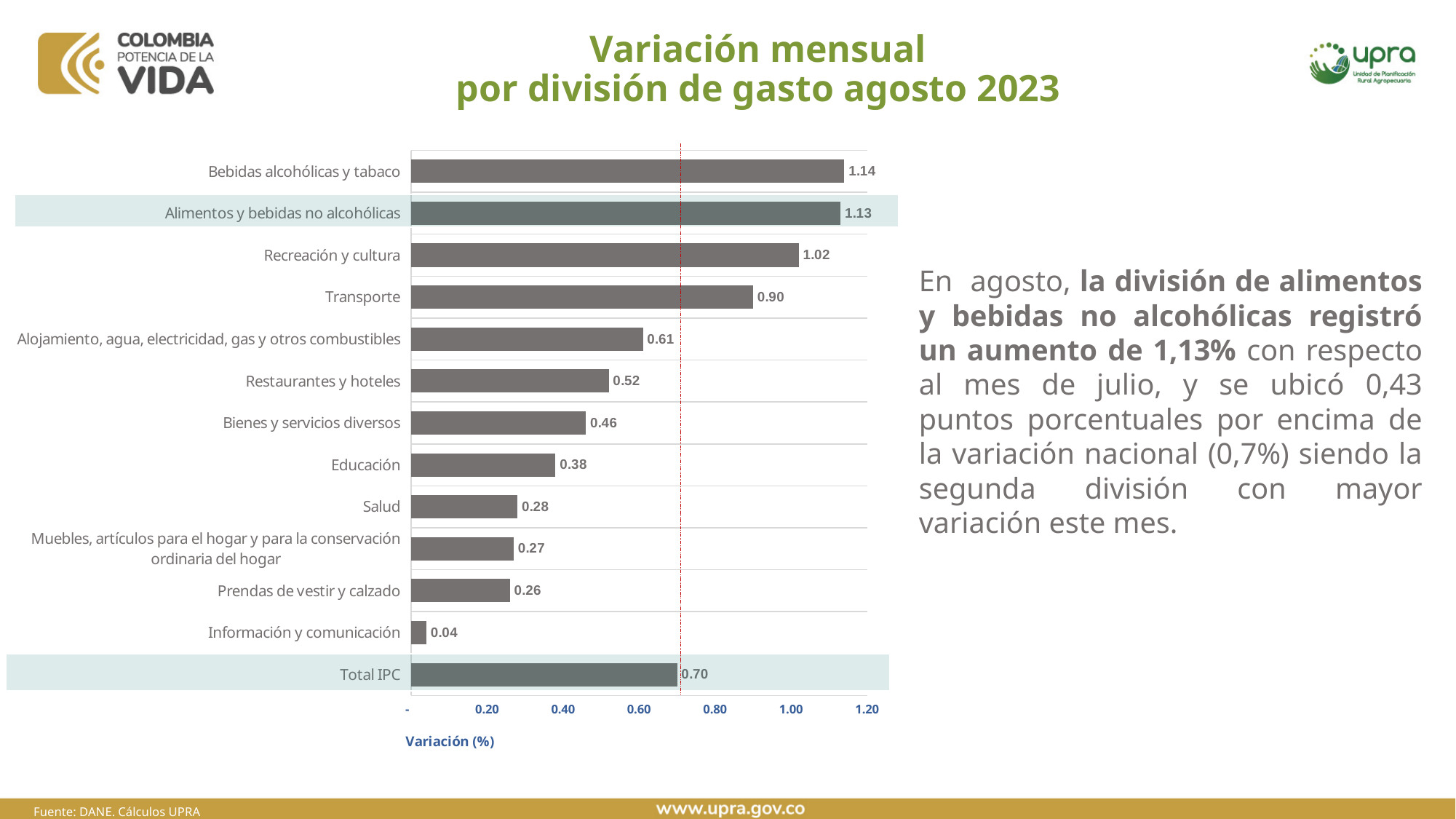
What kind of chart is shown on the slide? Bar chart How many categories are shown in the chart? 13 What is the value for Total IPC? 0.70 What is the value for Alimentos y bebidas no alcohólicas? 1.13 Which category has the highest value? Bebidas alcohólicas y tabaco Is the value for Recreación y cultura greater or less than 1.00? greater What is the difference between the values for Alimentos y bebidas no alcohólicas and Total IPC? 0.43 Which is larger, the value for Educación or the value for Salud? Educación What is the value for Transporte? 0.90 Which category has the lowest value? Información y comunicación What is the title of the slide? Variación mensual por división de gasto agosto 2023 What is the label of the horizontal axis? Variación (%)